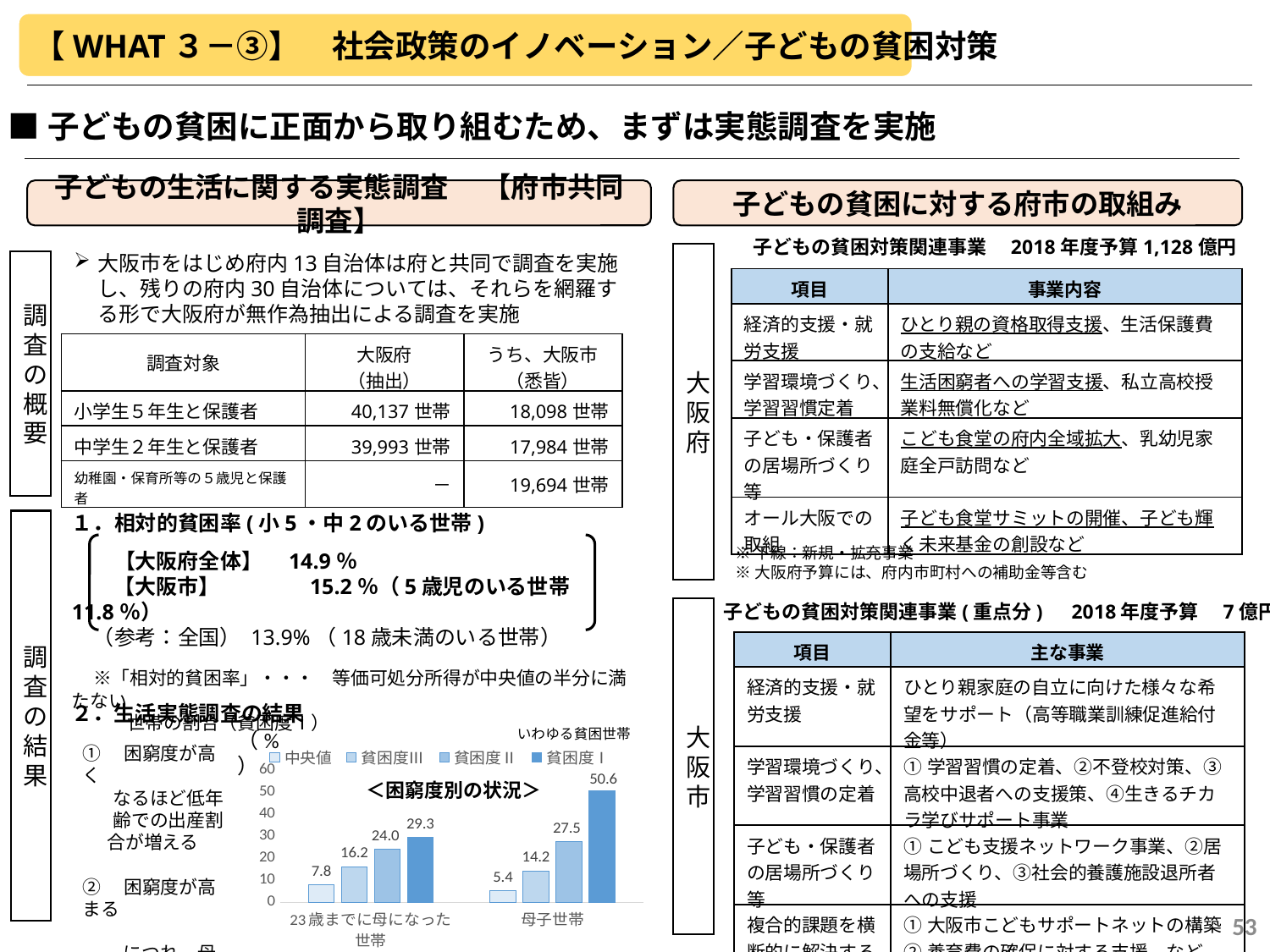
In the ＜困窮度別の状況＞ chart, which is larger: 貧困度Ⅱ for 23歳までに母になった世帯 or 貧困度Ⅱ for 母子世帯? 母子世帯 How many series does the legend of the ＜困窮度別の状況＞ chart list? 4 What kind of chart is shown under ＜困窮度別の状況＞? bar chart In the ＜困窮度別の状況＞ chart, what is the value of 貧困度Ⅲ for 23歳までに母になった世帯? 16.2 In the ＜困窮度別の状況＞ chart, which series has the highest value for 母子世帯? 貧困度Ⅰ In the ＜困窮度別の状況＞ chart, what is the value of 貧困度Ⅰ for 母子世帯? 50.6 How many categories are shown on the x axis of the ＜困窮度別の状況＞ chart? 2 In the ＜困窮度別の状況＞ chart, what is the value of 中央値 for 23歳までに母になった世帯? 7.8 In the ＜困窮度別の状況＞ chart, which series has the lowest value for 母子世帯? 中央値 In the ＜困窮度別の状況＞ chart, what is the difference between 貧困度Ⅰ for 母子世帯 and 貧困度Ⅰ for 23歳までに母になった世帯? 21.3 In the ＜困窮度別の状況＞ chart, is the value of 貧困度Ⅰ for 母子世帯 greater or less than 40? greater In the ＜困窮度別の状況＞ chart, what is the value of 貧困度Ⅱ for 母子世帯? 27.5